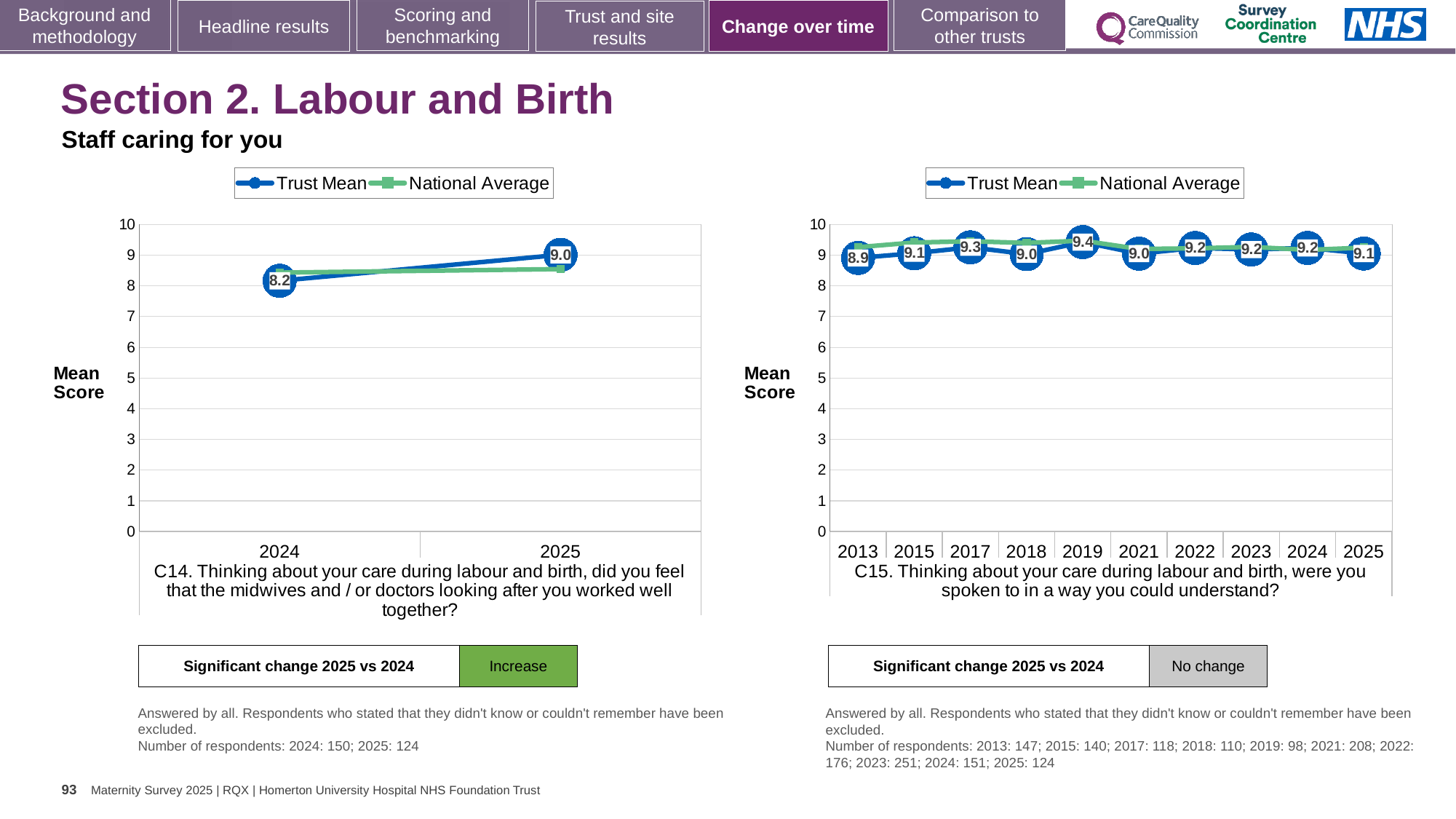
On the left chart (C14), does the Trust Mean rise or fall from 2024 to 2025? rise On the left chart (C14), what is the Trust Mean for 2024? 8.2 On the left chart (C14), what is the Trust Mean for 2025? 9.0 On the right chart (C15), what is the Trust Mean for 2019? 9.4 On the right chart (C15), how many years are shown on the x axis? 10 On the right chart (C15), what is the difference between the Trust Mean in 2017 and in 2018? 0.3 On the left chart (C14), is the National Average for 2025 greater or less than 8? greater On the right chart (C15), what is the Trust Mean for 2013? 8.9 On the right chart (C15), which year has the lowest Trust Mean? 2013 On the left chart (C14), by how much did the Trust Mean change from 2024 to 2025? 0.8 How many series does the legend of the left chart (C14) list? 2 On the right chart (C15), which year has the highest Trust Mean? 2019